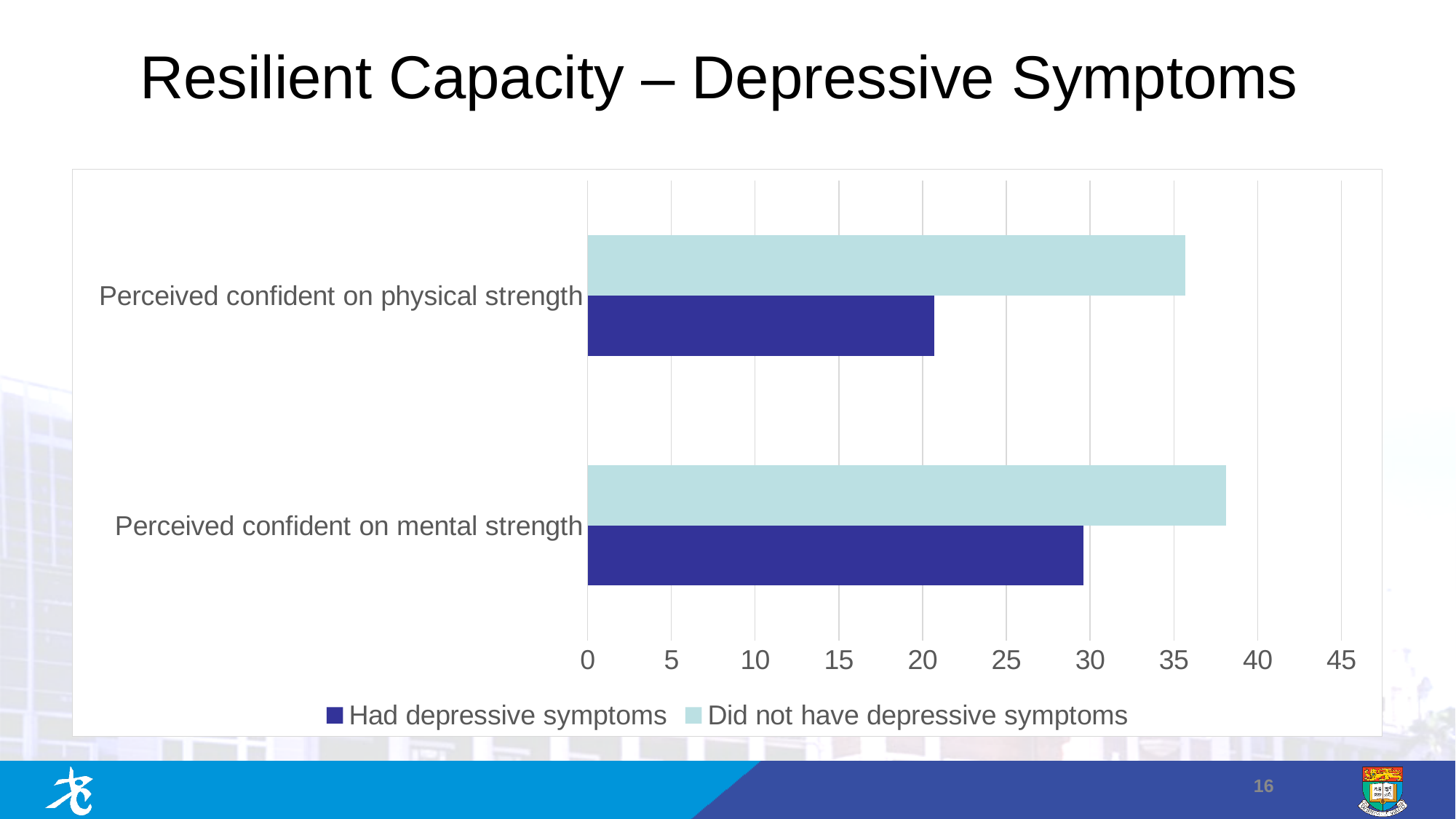
Is the value for 'Did not have depressive symptoms' on 'Perceived confident on mental strength' greater or less than 35? greater Is the value for 'Did not have depressive symptoms' on 'Perceived confident on physical strength' greater or less than 30? greater For the 'Had depressive symptoms' series, which category has the larger value? Perceived confident on mental strength For 'Perceived confident on physical strength', which series has the larger value? Did not have depressive symptoms Which bar on the chart is the shortest? Had depressive symptoms, Perceived confident on physical strength Is the value for 'Had depressive symptoms' on 'Perceived confident on physical strength' greater or less than 25? less Which series does the dark blue colour represent? Had depressive symptoms How many series does the legend list? 2 How many categories are shown on the chart? 2 Which bar on the chart is the longest? Did not have depressive symptoms, Perceived confident on mental strength What kind of chart is shown on the slide? bar chart